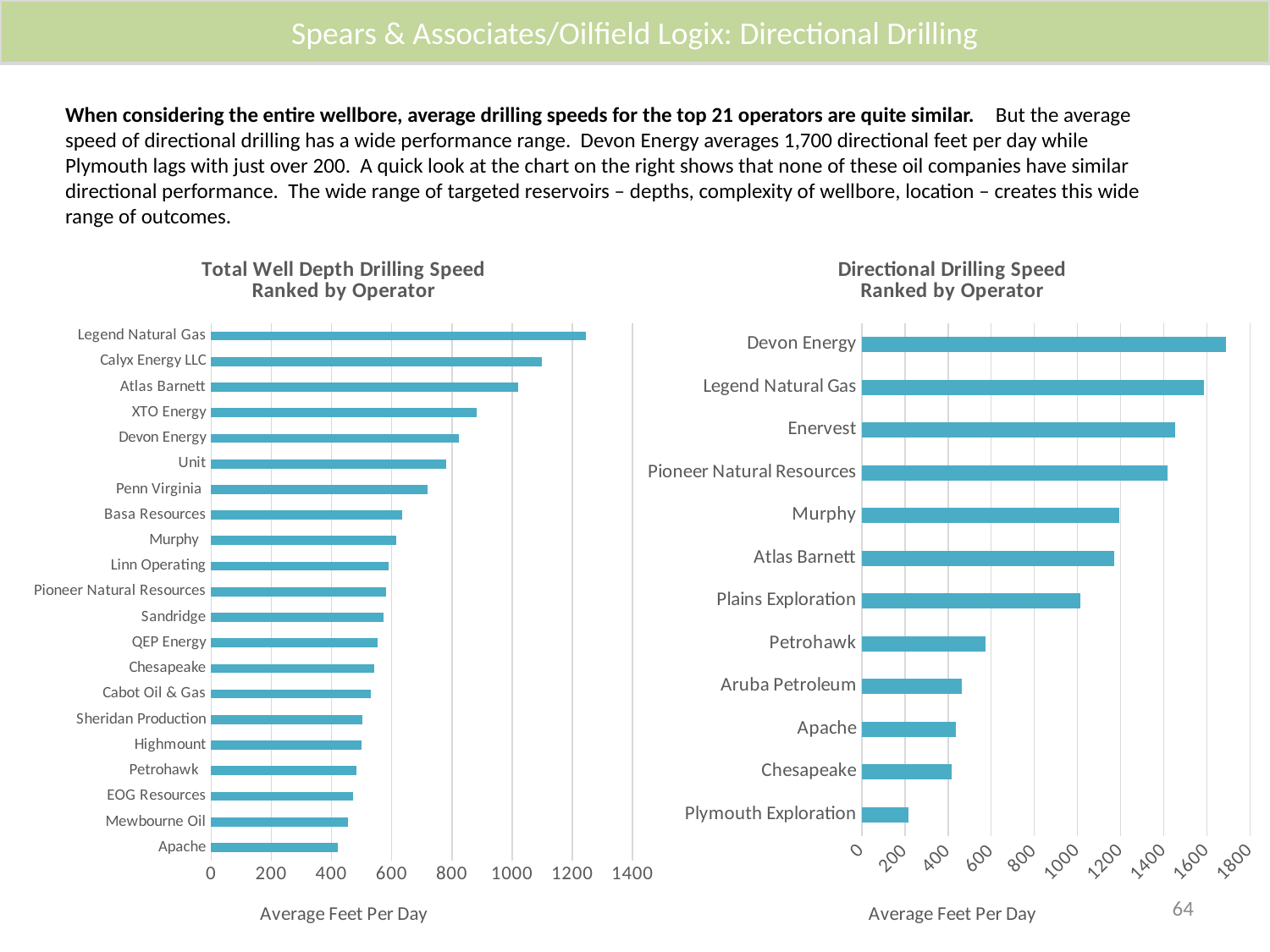
On the Total Well Depth Drilling Speed chart, which operator has the lowest value? Apache On the Directional Drilling Speed chart, is the value for Devon Energy greater or less than 1600? greater On the Directional Drilling Speed chart, how many operators are shown? 12 On the Total Well Depth Drilling Speed chart, is the value for Legend Natural Gas greater or less than 1200? greater On the Directional Drilling Speed chart, is the value for Plymouth Exploration greater or less than 400? less On the Directional Drilling Speed chart, which has the larger value, Devon Energy or Legend Natural Gas? Devon Energy On the Directional Drilling Speed chart, which operator has the highest value? Devon Energy What kind of chart is the Directional Drilling Speed chart? Bar chart On the Total Well Depth Drilling Speed chart, which operator has the highest value? Legend Natural Gas On the Directional Drilling Speed chart, which operator has the lowest value? Plymouth Exploration On the Total Well Depth Drilling Speed chart, how many operators are shown? 21